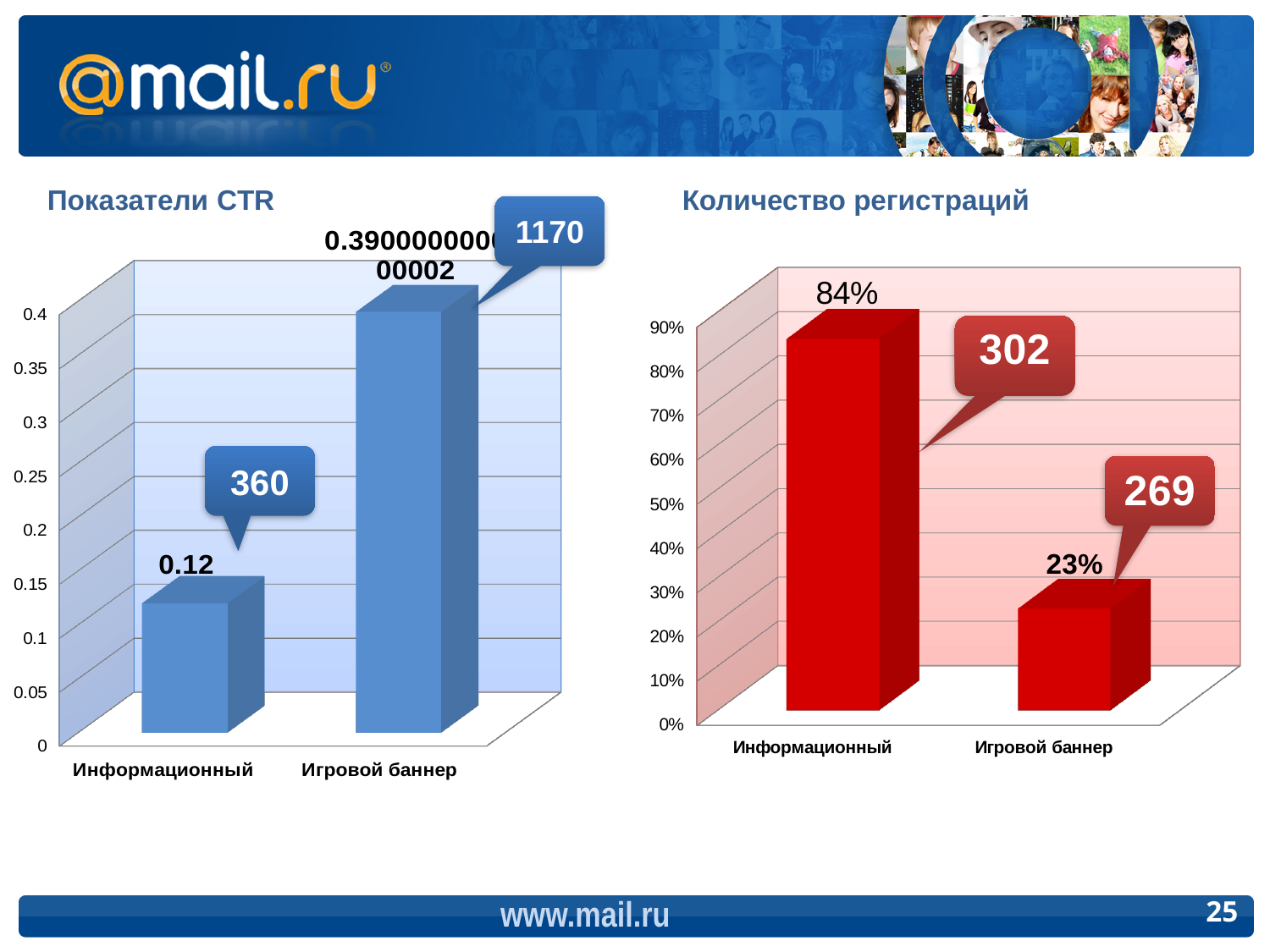
In the chart titled "Количество регистраций", what is the value for Информационный? 84% In the chart titled "Показатели CTR", is the value for Игровой баннер greater or less than 0.35? greater In the chart titled "Количество регистраций", what is the difference between the values for Информационный and Игровой баннер? 61% In the chart titled "Количество регистраций", what number is shown in the callout pointing to the Игровой баннер bar? 269 In the chart titled "Показатели CTR", what is the value for Информационный? 0.12 In the chart titled "Количество регистраций", which category has the highest value? Информационный What kind of chart is the chart titled "Количество регистраций"? bar chart In the chart titled "Показатели CTR", which category has the higher value, Информационный or Игровой баннер? Игровой баннер In the chart titled "Показатели CTR", which category has the lowest value? Информационный How many categories are shown in the chart titled "Показатели CTR"? 2 In the chart titled "Количество регистраций", is the value for Игровой баннер greater or less than 30%? less In the chart titled "Количество регистраций", what is the value for Игровой баннер? 23%